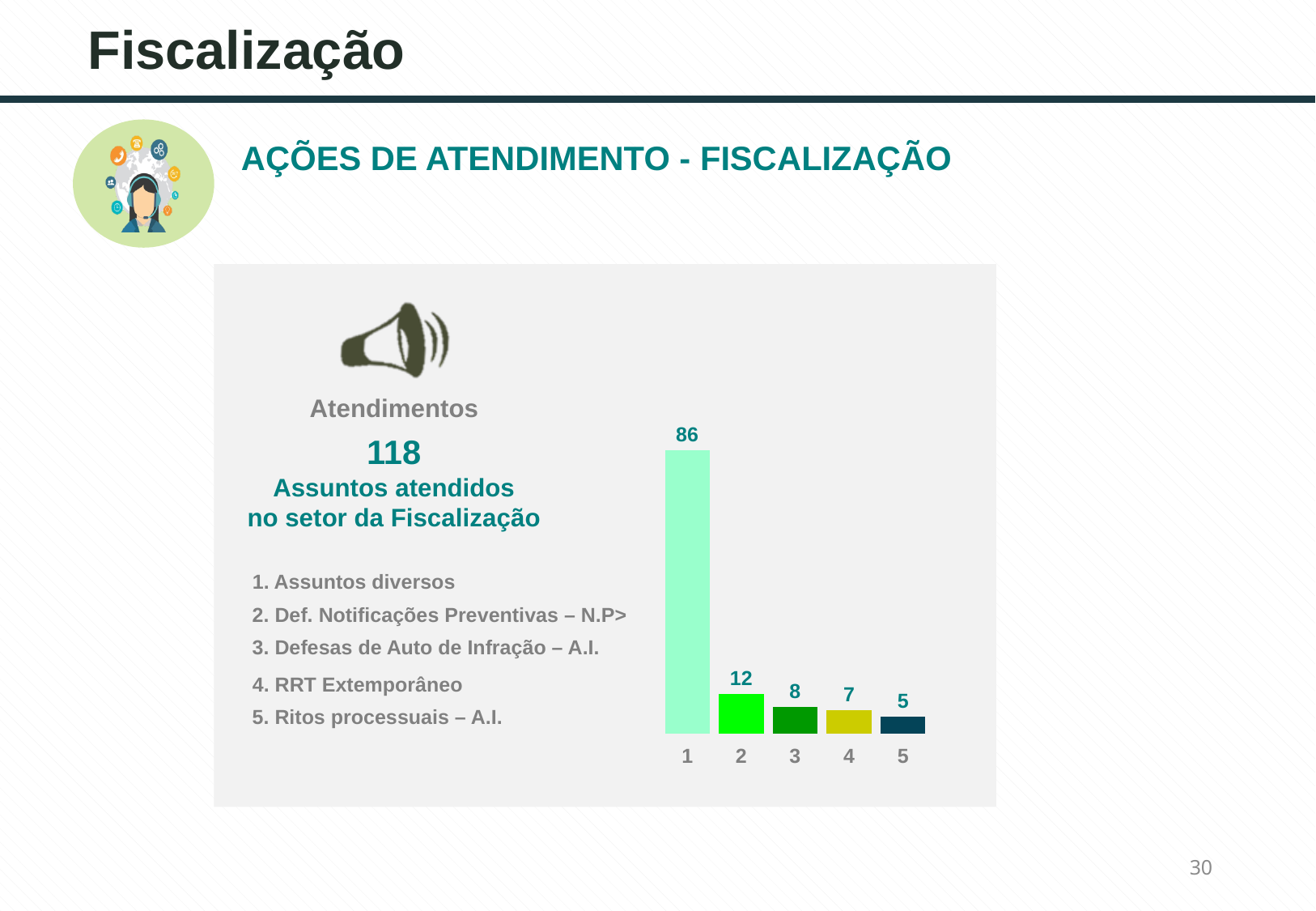
What is the value for category 2 (Def. Notificações Preventivas – N.P) in the bar chart? 12 How many categories are shown in the bar chart? 5 Which category has the highest value in the bar chart? 1 (Assuntos diversos) What is the value for category 1 (Assuntos diversos) in the bar chart? 86 What is the value for category 5 (Ritos processuais – A.I.) in the bar chart? 5 What is the difference between the values for category 3 and category 4? 1 What kind of chart is shown on the slide? Bar chart Do the values rise or fall from category 1 to category 5 along the x axis? Fall What is the difference between the values for category 1 and category 2? 74 What is the total number of 'Assuntos atendidos no setor da Fiscalização' stated on the slide? 118 Which category has the lowest value in the bar chart? 5 (Ritos processuais – A.I.) Which is larger, the value for category 3 or the value for category 4? Category 3